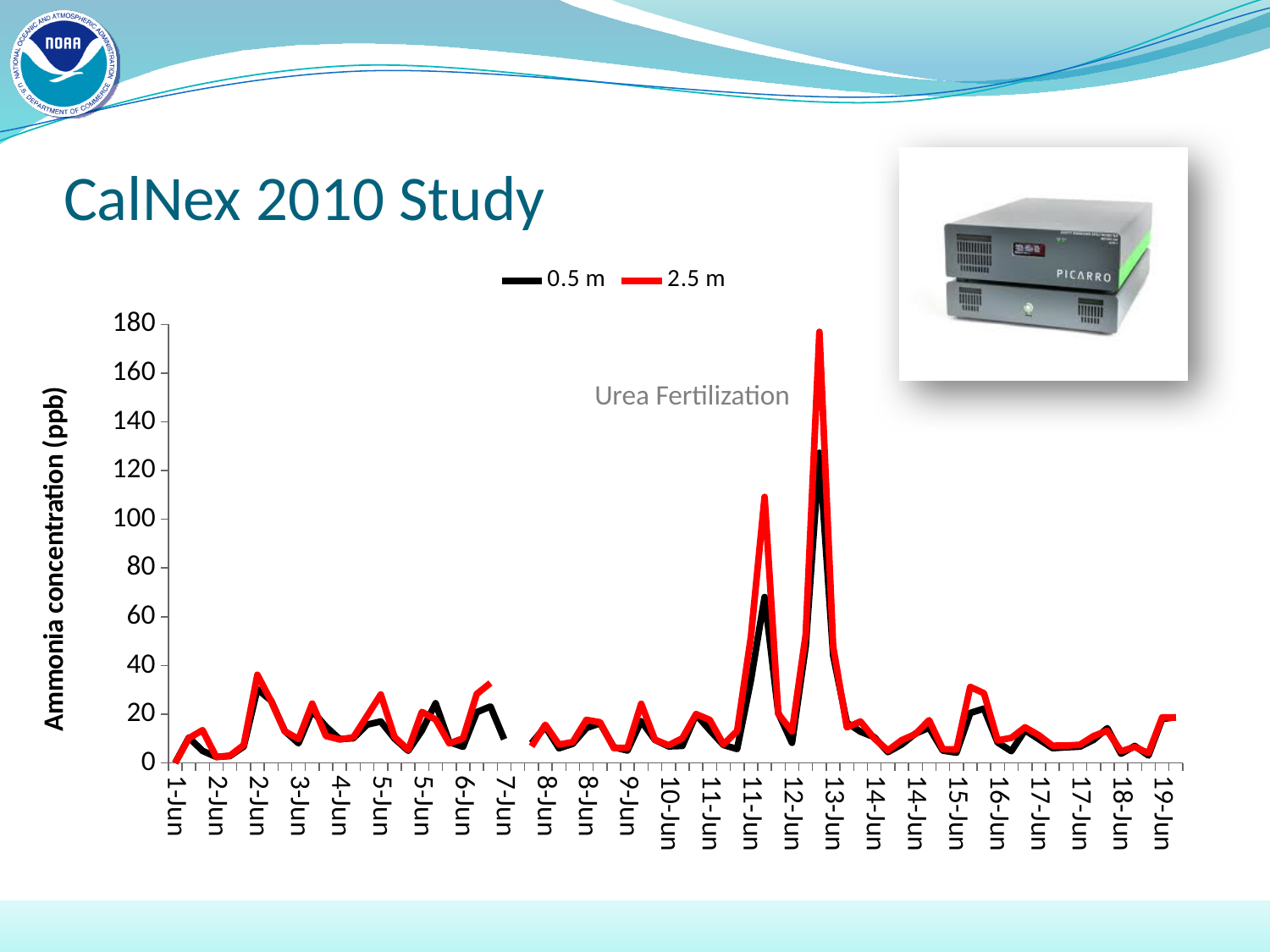
What are the two series named in the chart legend? 0.5 m and 2.5 m Is the peak value of the 2.5 m series near 11-Jun greater or less than 80? greater Is the peak value of the 0.5 m series near 11-Jun greater or less than 80? less Which series reaches the highest value on the chart, 0.5 m or 2.5 m? 2.5 m What is the label of the vertical axis of the chart? Ammonia concentration (ppb) Is the value of the 2.5 m series at 1-Jun greater or less than 20? less How many series does the chart legend list? 2 What is the highest tick value shown on the vertical axis of the chart? 180 What kind of chart is shown on the slide? line chart Around which date does the 2.5 m series reach its highest value? 13-Jun